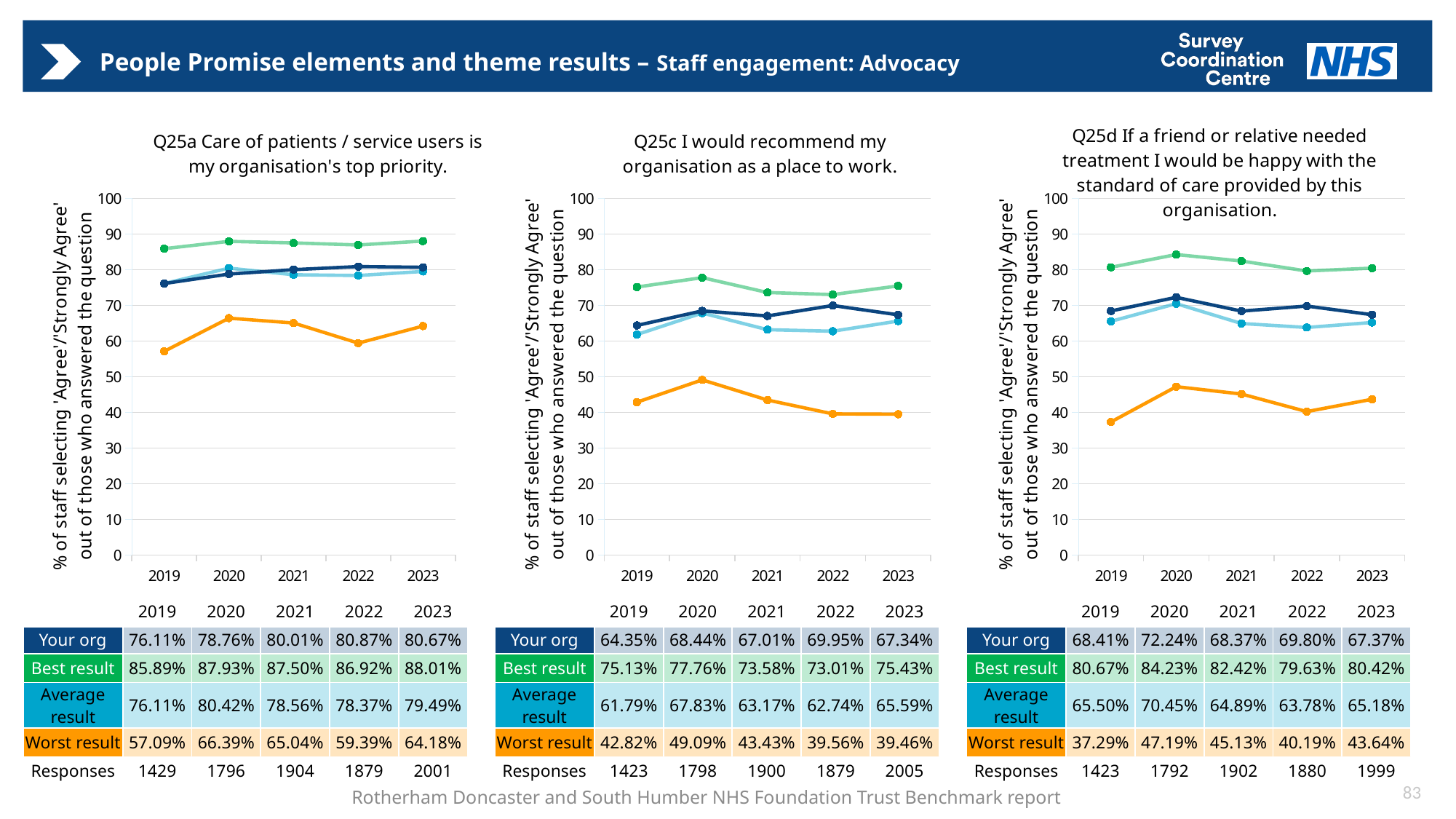
How many years are shown on the x axis of the Q25c chart? 5 In the Q25a chart, in which year is the 'Your org' value highest? 2022 What kind of chart is used for Q25a? line chart In the Q25a chart (Care of patients / service users is my organisation's top priority), what is the 'Your org' value for 2023? 80.67% In the Q25d chart (If a friend or relative needed treatment...), what is the 'Best result' value for 2020? 84.23% In the Q25d chart, how many responses were recorded for 2023? 1999 In the Q25c chart, what is the difference between the 'Best result' and 'Your org' values for 2023? 8.09 percentage points In the Q25c chart, does the 'Worst result' line rise or fall from 2020 to 2023? falls In the Q25d chart, which is larger for 2021: the 'Your org' value or the 'Average result' value? Your org In the Q25c chart (I would recommend my organisation as a place to work), what is the 'Worst result' value for 2022? 39.56% In the Q25a chart, is the 'Worst result' value for 2019 greater or less than 60? less In the Q25d chart, in which year is the 'Worst result' value lowest? 2019